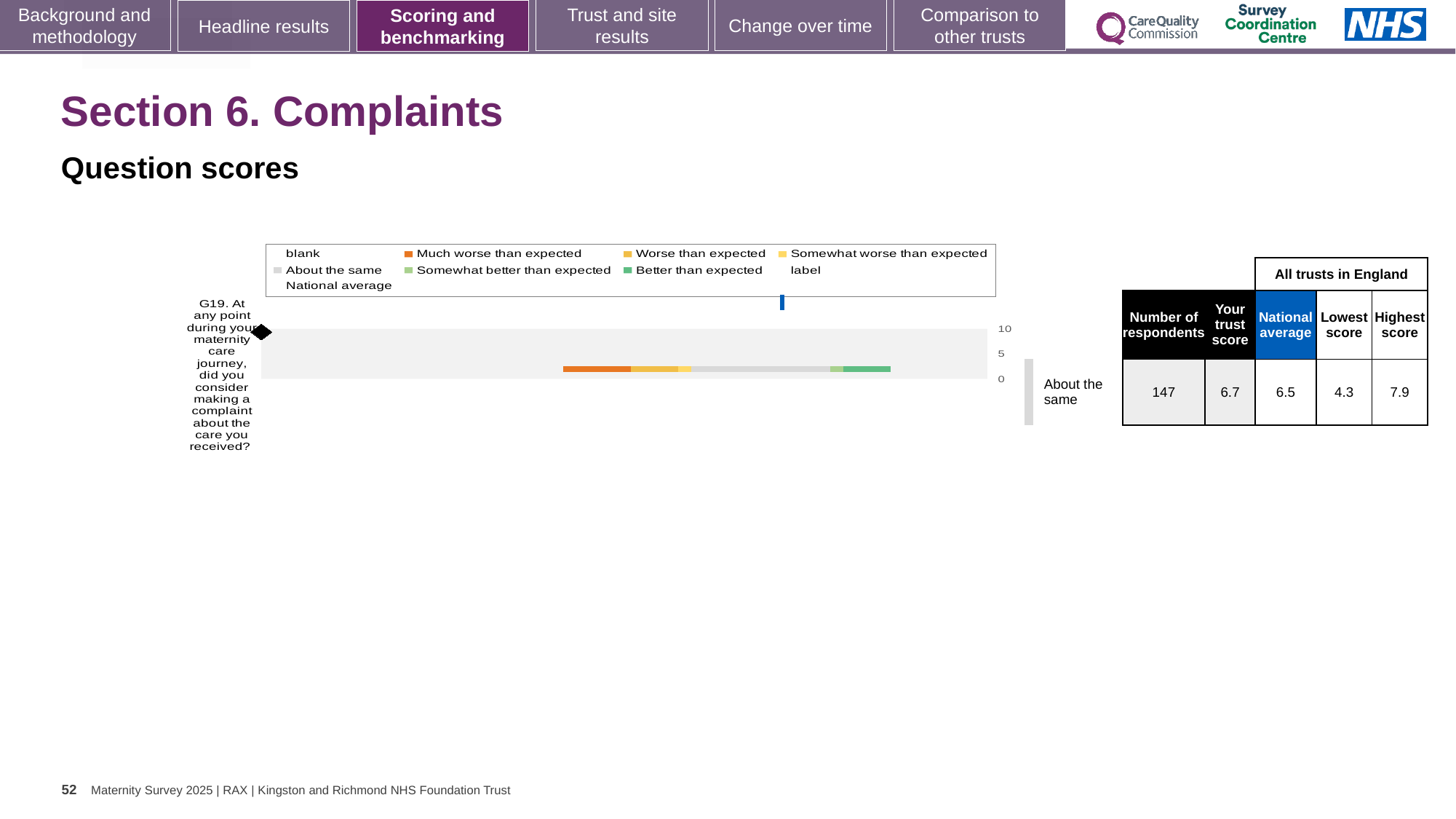
How many respondents answered question G19? 147 What is the lowest score among all trusts in England for question G19? 4.3 What is the trust's score for question G19? 6.7 What is the highest score among all trusts in England for question G19? 7.9 What is the highest value shown on the chart's score axis? 10 Which question is plotted on the chart? G19. At any point during your maternity care journey, did you consider making a complaint about the care you received? Which benchmark category is the trust's score for question G19 placed in? About the same How many survey questions are plotted on the chart? 1 Which is larger for question G19, the trust score or the national average? trust score What is the difference between the highest and lowest trust scores in England for question G19? 3.6 What kind of chart is shown on the slide? bar chart What is the national average score for question G19? 6.5